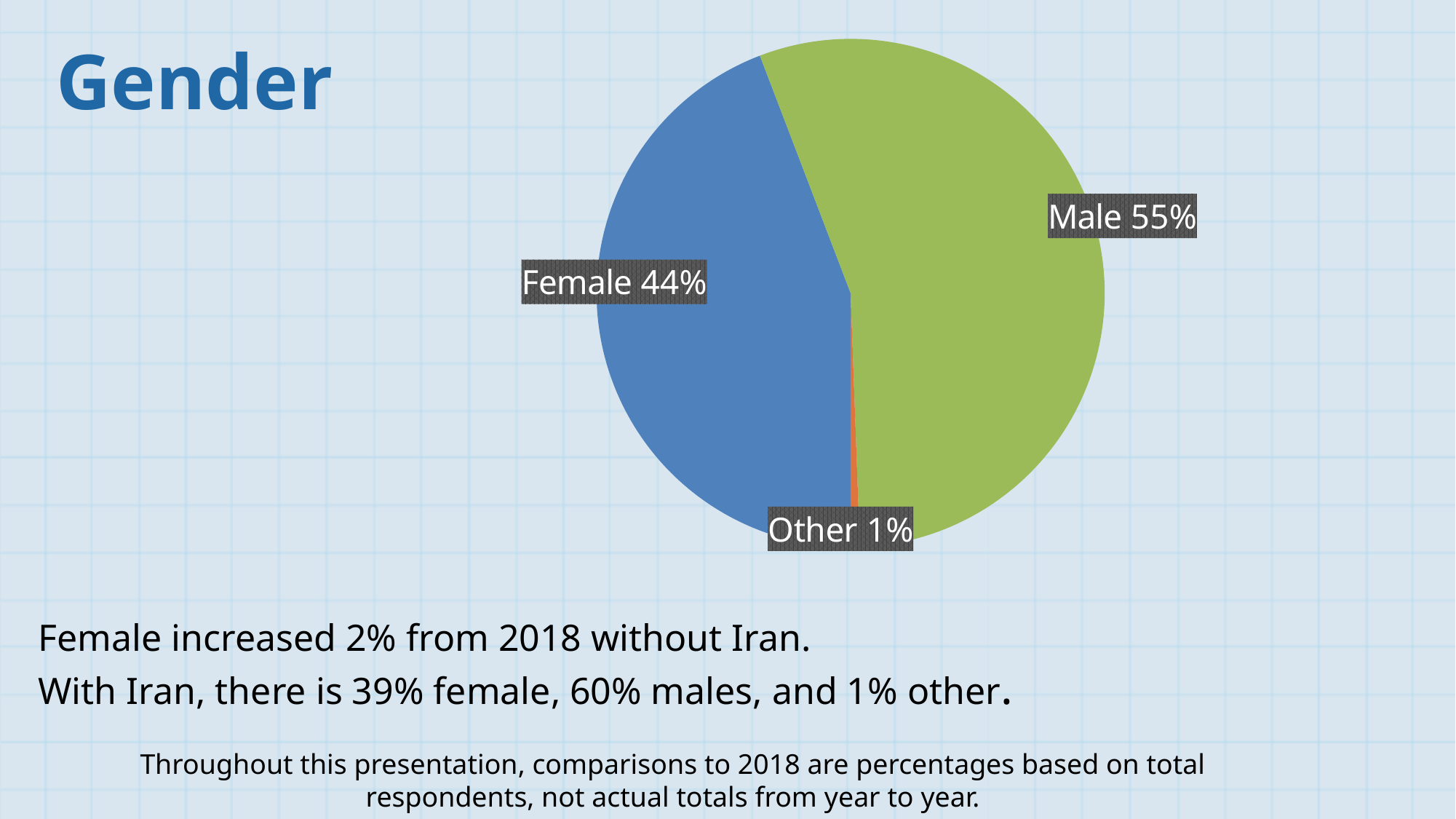
Which category has the largest share of the pie? Male Which category has the smallest share of the pie? Other What percentage of the pie is Male? 55% What is the difference in percentage points between Female and Other? 43% Which is larger, the Female slice or the Male slice? Male What is the difference in percentage points between Male and Female? 11% How many slices does the pie chart have? 3 What percentage of the pie is Female? 44% What colour is the Male slice of the pie chart? green What percentage of the pie is Other? 1% What is the title of the slide containing the pie chart? Gender What kind of chart is shown on the slide? pie chart